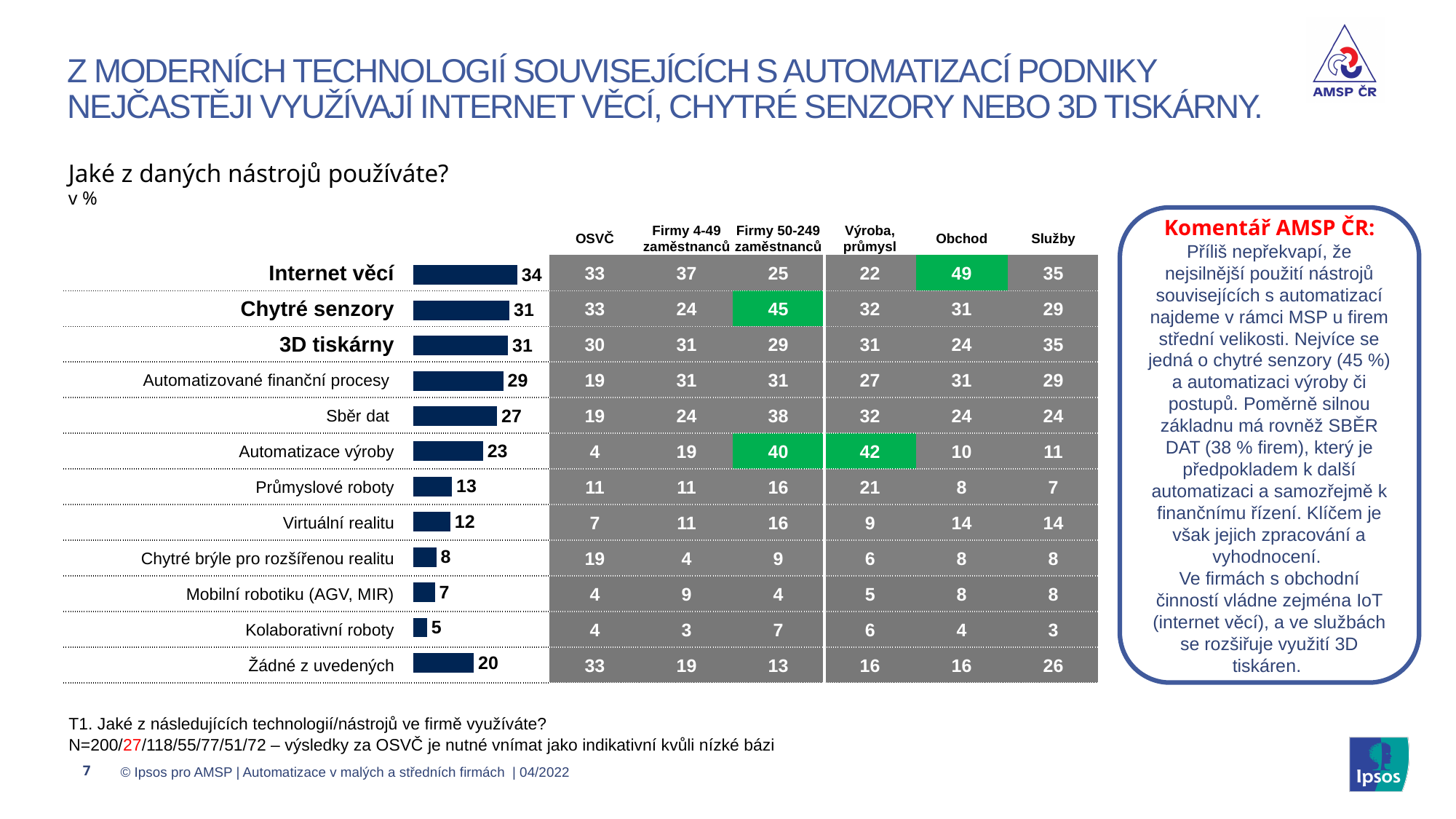
What unit is stated for the values in the chart, as shown under the question text? v % What kind of chart is shown on the slide? Bar chart Which category has the lowest value in the bar chart? Kolaborativní roboty What is the value shown for Internet věcí in the bar chart? 34 Which category has the highest value in the bar chart? Internet věcí What is the value shown for Žádné z uvedených in the bar chart? 20 What is the value shown for Sběr dat in the bar chart? 27 Which has a larger value in the bar chart, Mobilní robotiku (AGV, MIR) or Chytré brýle pro rozšířenou realitu? Chytré brýle pro rozšířenou realitu What is the difference between the values for Internet věcí and Automatizace výroby in the bar chart? 11 Which has a larger value in the bar chart, Automatizované finanční procesy or Sběr dat? Automatizované finanční procesy How many categories are shown in the bar chart? 12 What is the difference between the values for Průmyslové roboty and Virtuální realitu in the bar chart? 1